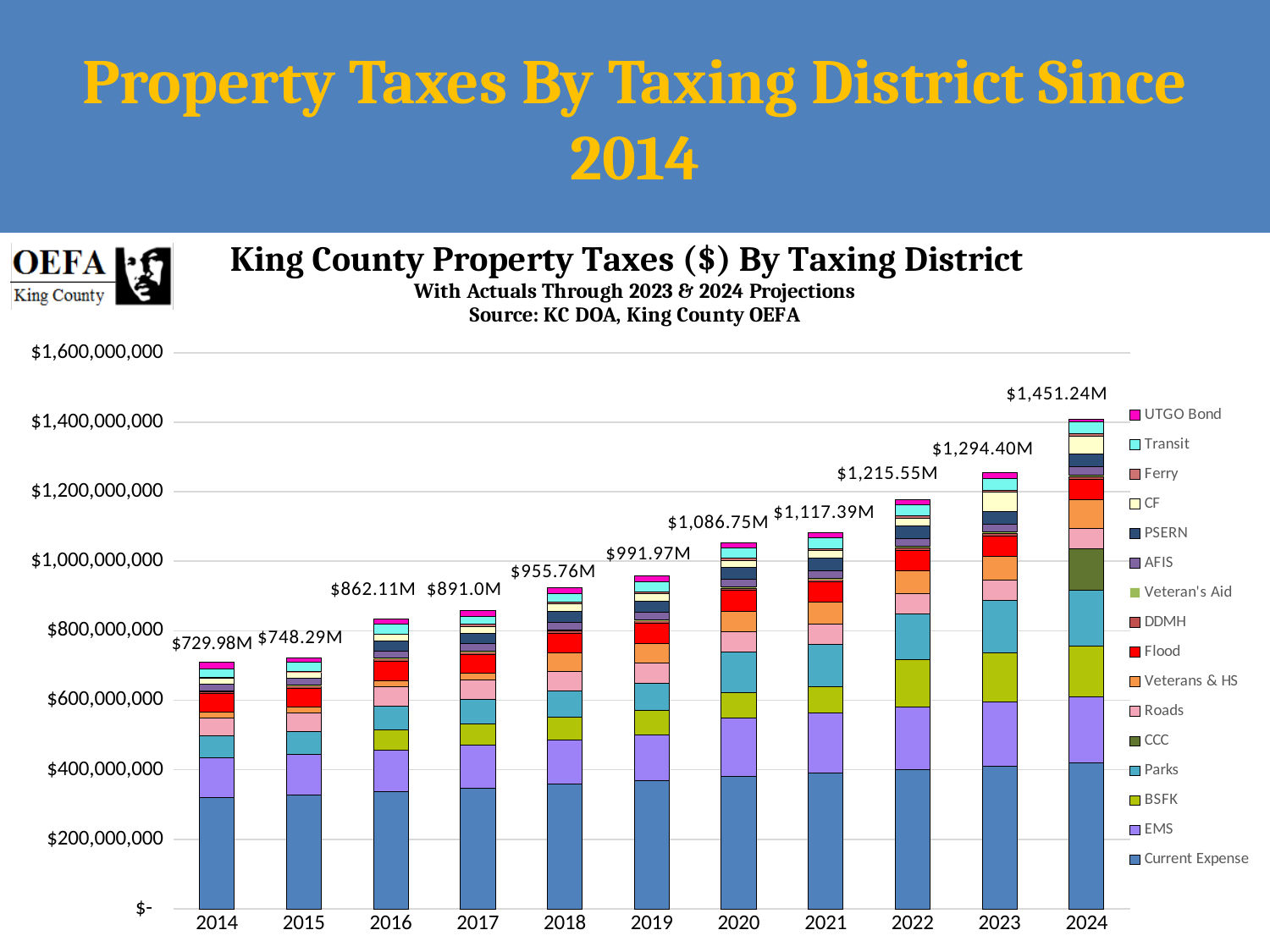
What is the total property tax value shown for 2020? $1,086.75M What is the total property tax value shown for 2014? $729.98M How many years are shown on the x axis? 11 What is the total property tax value projected for 2024? $1,451.24M What kind of chart is shown on the slide? Stacked bar chart What is the difference between the 2024 total and the 2023 total? $156.84M Is the Current Expense value for 2014 greater or less than $400,000,000? less Which year has the highest total property tax value? 2024 Which year has the lowest total property tax value? 2014 How many taxing districts does the legend list? 16 Which year has a larger total, 2017 or 2018? 2018 Do the total property tax values rise or fall from 2014 to 2024? Rise